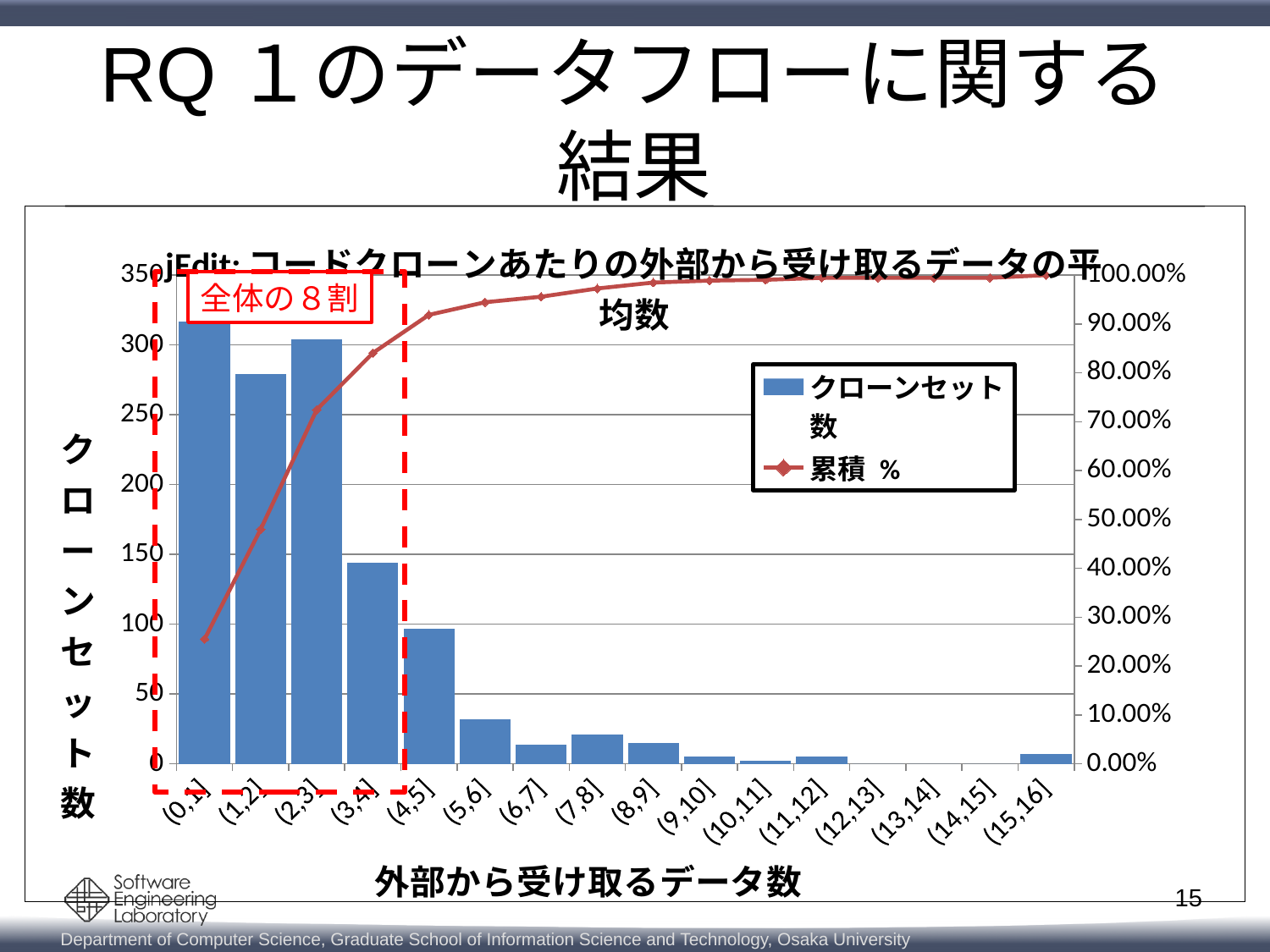
Which has a larger クローンセット数 value, (0,1] or (3,4]? (0,1] What are the two entries listed in the legend? クローンセット数 and 累積 % Is the クローンセット数 value for (1,2] greater or less than 250? greater Which has a larger クローンセット数 value, (4,5] or (5,6]? (4,5] Does the 累積 % line rise or fall from left to right along the x axis? rise Is the クローンセット数 value for (0,1] greater or less than 300? greater What kind of chart is shown on the slide? A bar chart combined with a line chart Which category has the highest クローンセット数 bar? (0,1] Is the クローンセット数 value for (3,4] greater or less than 150? less How many categories are shown on the x axis? 16 How many series does the legend list? 2